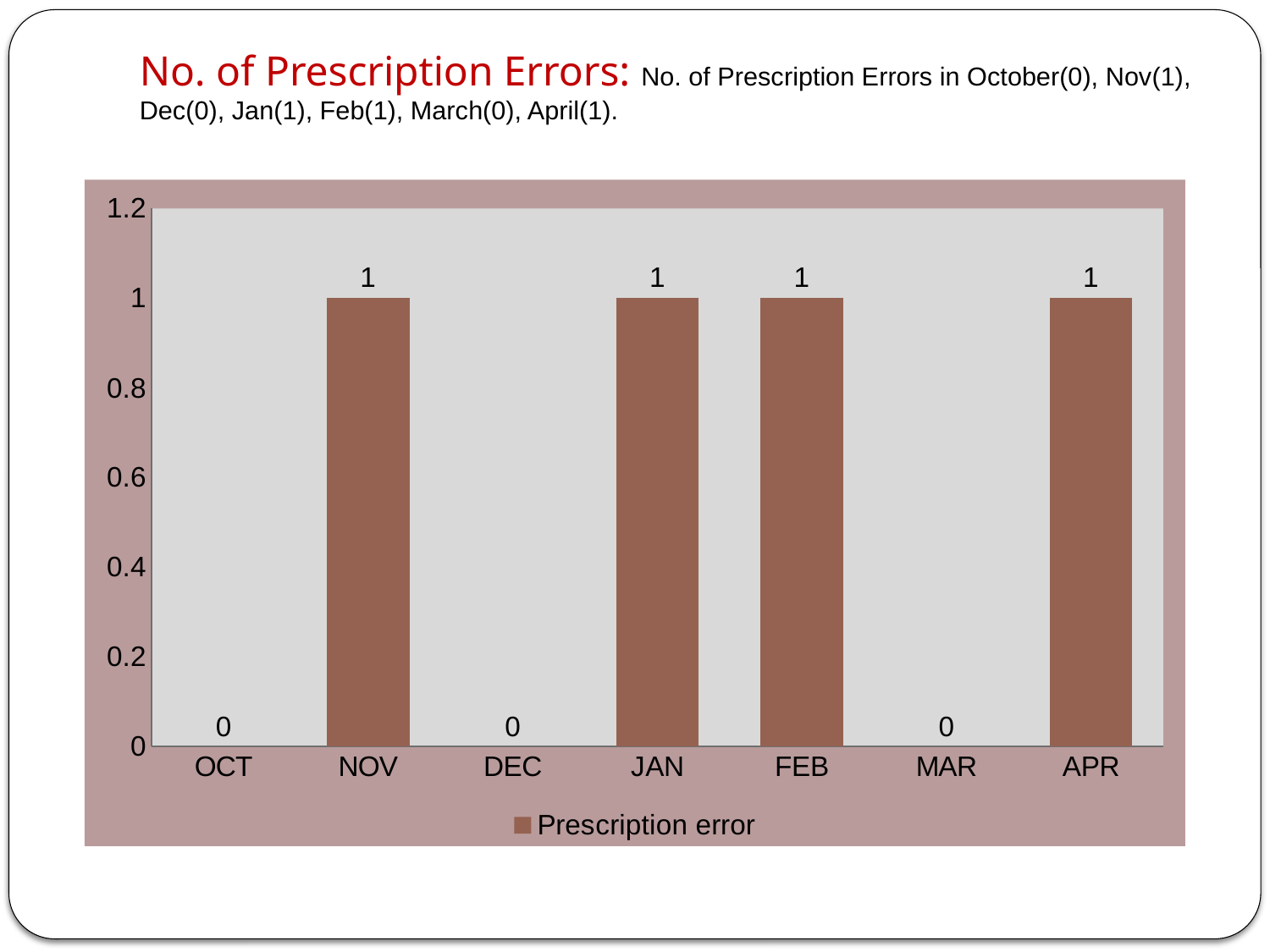
What is the name of the series in the legend? Prescription error What is the value for NOV? 1 What is the value for MAR? 0 How many months have a value of 0? 3 What is the value for APR? 1 Is the value for OCT greater or less than 0.2? less How many categories are shown on the x axis? 7 Which is larger, the value for FEB or the value for MAR? FEB How many series does the legend list? 1 What kind of chart is shown? bar chart What is the difference between the value for JAN and the value for DEC? 1 What is the value for DEC? 0